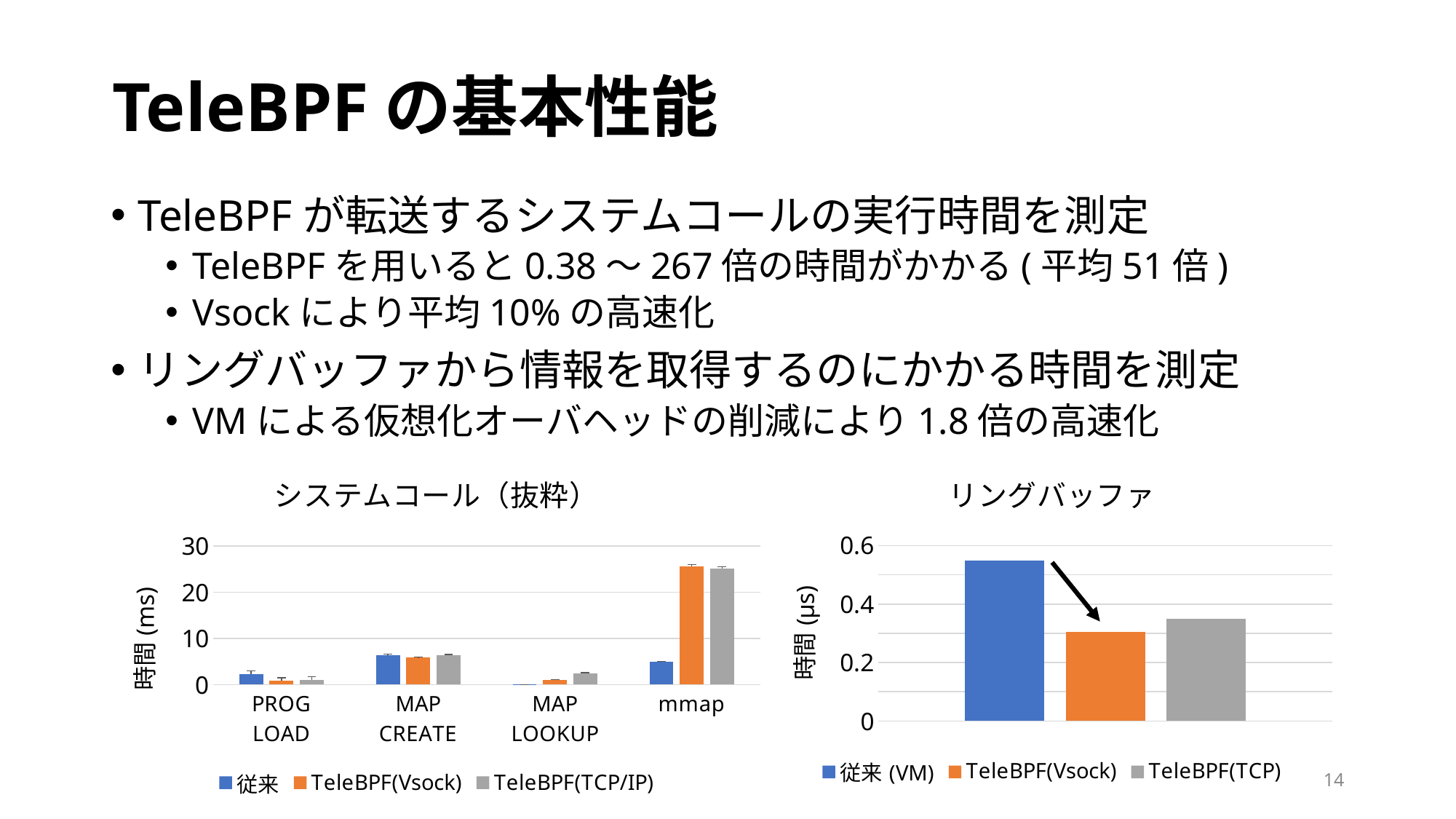
In the リングバッファ chart, which series has the highest value? 従来 (VM) In the システムコール（抜粋） chart, how many series does the legend list? 3 In the システムコール（抜粋） chart, is the TeleBPF(Vsock) value for mmap greater or less than 20? greater What is the y-axis label of the リングバッファ chart? 時間 (µs) In the システムコール（抜粋） chart, which category has the highest TeleBPF(TCP/IP) value? mmap In the リングバッファ chart, is the value for 従来 (VM) greater or less than 0.4? greater In the システムコール（抜粋） chart, how many categories are shown on the x axis? 4 In the システムコール（抜粋） chart, is the 従来 value for PROG LOAD greater or less than 10? less In the システムコール（抜粋） chart, for MAP LOOKUP, which is larger: 従来 or TeleBPF(TCP/IP)? TeleBPF(TCP/IP) What kind of chart is the リングバッファ chart? bar chart In the リングバッファ chart, which series has the lowest value? TeleBPF(Vsock) In the システムコール（抜粋） chart, for PROG LOAD, which is larger: 従来 or TeleBPF(Vsock)? 従来